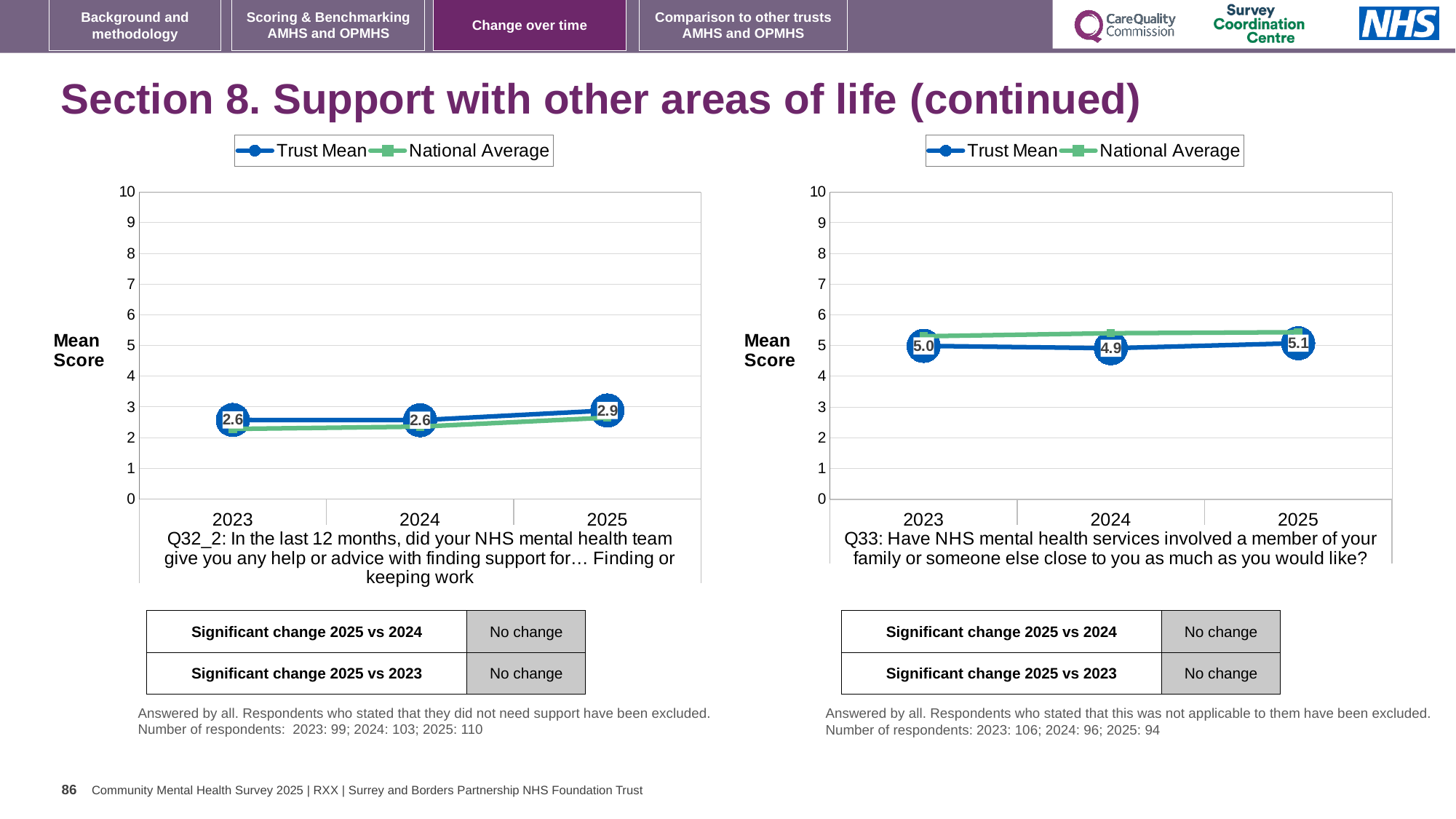
On the left chart (Q32_2), what is the difference between the Trust Mean in 2025 and in 2024? 0.3 On the left chart (Q32_2), what is the Trust Mean for 2023? 2.6 On the right chart (Q33), what is the Trust Mean for 2024? 4.9 On the right chart (Q33), which year has the highest Trust Mean? 2025 On the right chart (Q33), what is the Trust Mean for 2025? 5.1 On the right chart (Q33), which year has the lowest Trust Mean? 2024 On the left chart (Q32_2), what is the Trust Mean for 2025? 2.9 On the left chart (Q32_2), is the National Average for 2023 greater or less than 3? less How many years are plotted on the x axis of the left chart (Q32_2)? 3 How many series does the legend of the right chart (Q33) list? 2 What type of chart is the left chart (Q32_2)? line chart On the right chart (Q33), is the Trust Mean for 2025 larger or smaller than the Trust Mean for 2023? larger